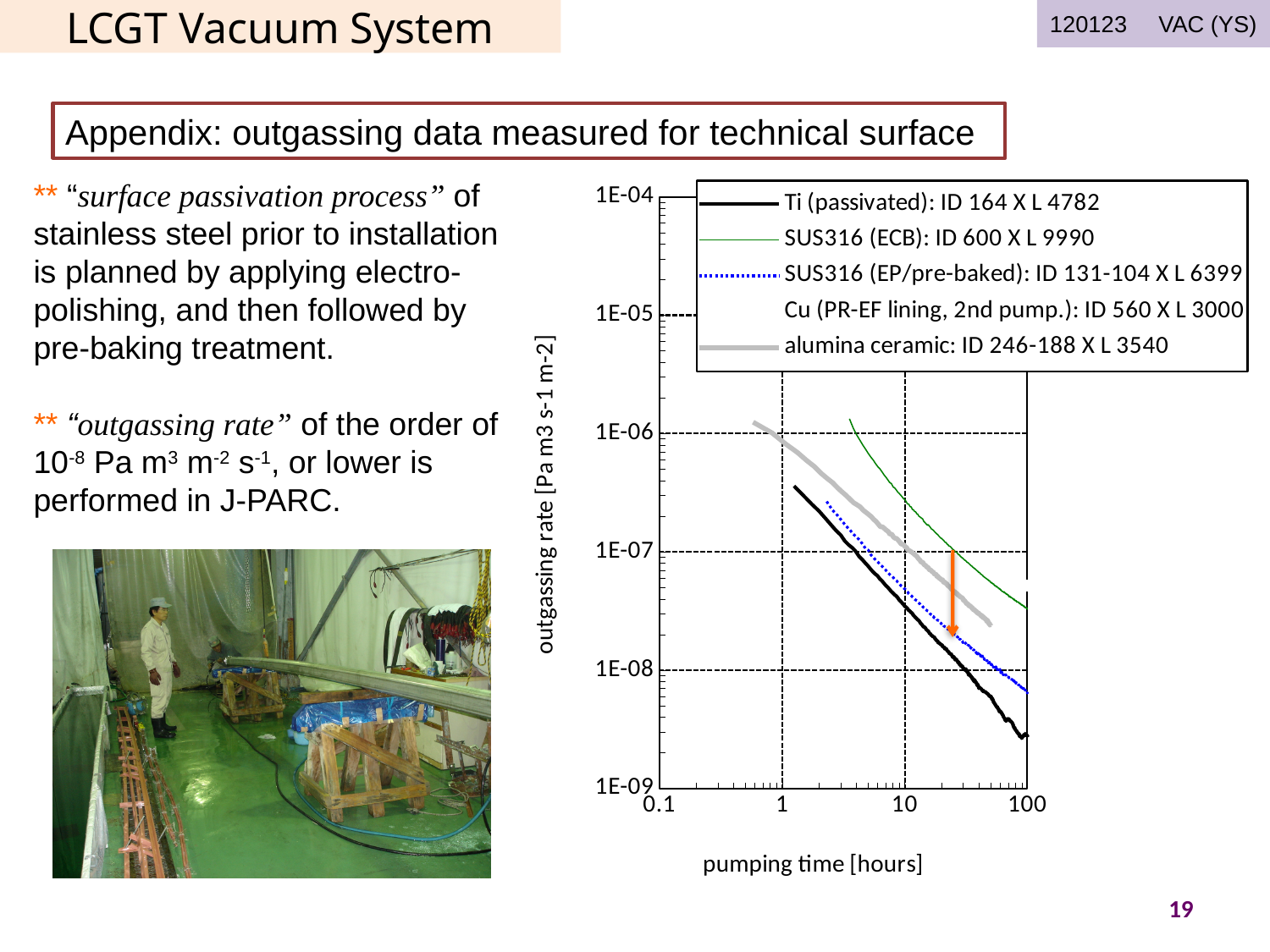
Is the outgassing rate for Cu (PR-EF lining, 2nd pump.) at 10 hours greater or less than 1E-07? greater Is the outgassing rate for alumina ceramic at 50 hours greater or less than 1E-08? greater At 100 hours of pumping time, which series has the lowest outgassing rate? Ti (passivated) What kind of chart is shown on the slide? line chart Is the outgassing rate for Ti (passivated) at 100 hours greater or less than 1E-08? less How many series does the chart legend list? 5 At 10 hours of pumping time, which has the higher outgassing rate, alumina ceramic or Ti (passivated)? alumina ceramic What is the label of the x axis of the chart? pumping time [hours] At 10 hours of pumping time, which series has the highest outgassing rate? Cu (PR-EF lining, 2nd pump.) What is the label of the y axis of the chart? outgassing rate [Pa m3 s-1 m-2] Do the outgassing rate curves rise or fall as pumping time increases? fall